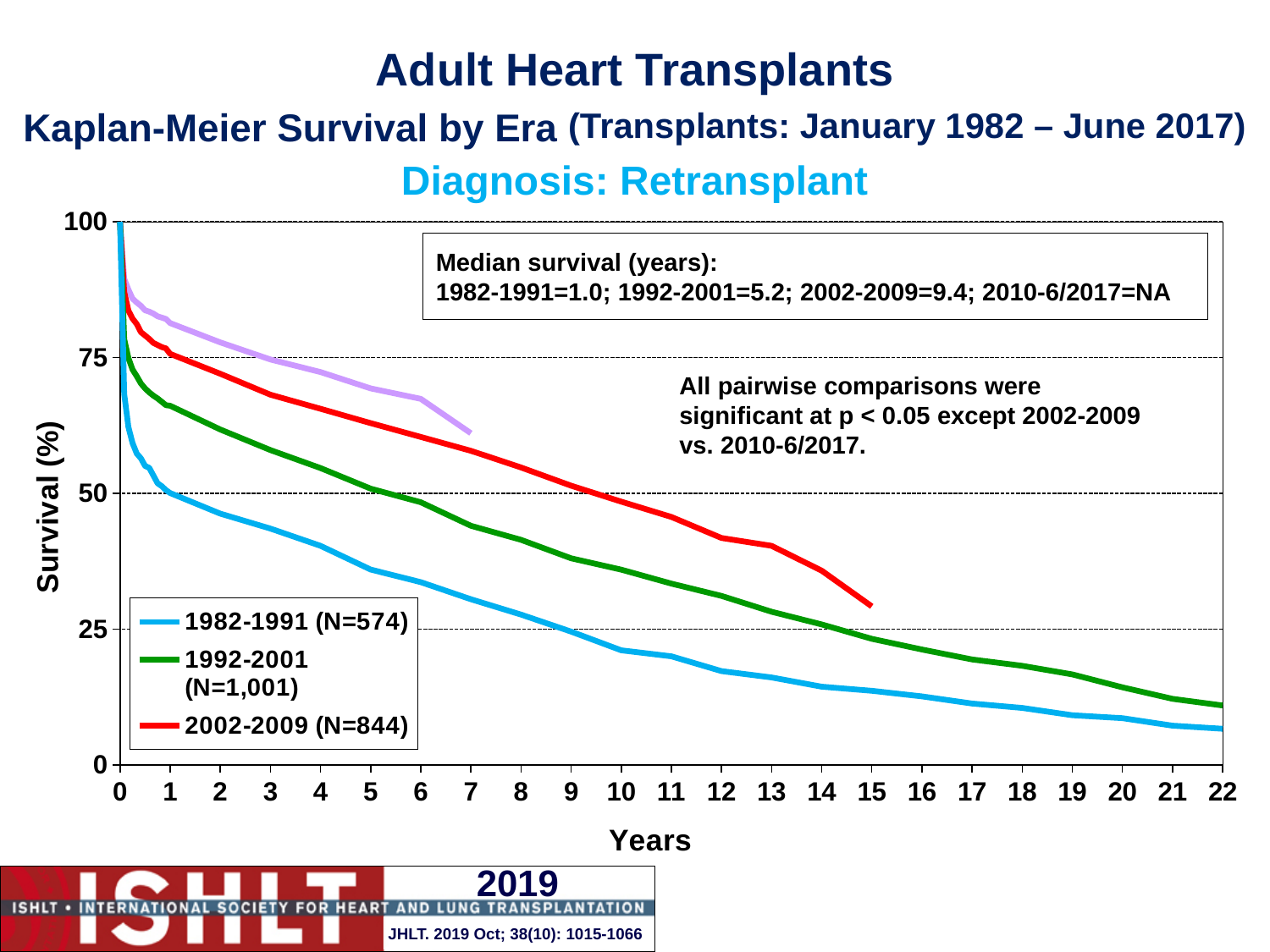
What kind of chart is shown on the slide? line chart Is the survival for the 1982-1991 era at 10 years greater or less than 25%? less What is the difference in median survival (years) between the 2002-2009 era and the 1992-2001 era? 4.2 What is the median survival in years for the 1982-1991 era? 1.0 How many series does the chart legend list? 3 What is the median survival given for the 2010-6/2017 era? NA Is the survival for the 2002-2009 era at 5 years greater or less than 50%? greater What is the median survival in years for the 2002-2009 era? 9.4 What is the median survival in years for the 1992-2001 era? 5.2 At 10 years, which era has higher survival: 2002-2009 or 1982-1991? 2002-2009 Among the eras with a numeric median survival, which era has the highest median survival? 2002-2009 How many patients (N) are in the 1992-2001 era according to the legend? 1,001